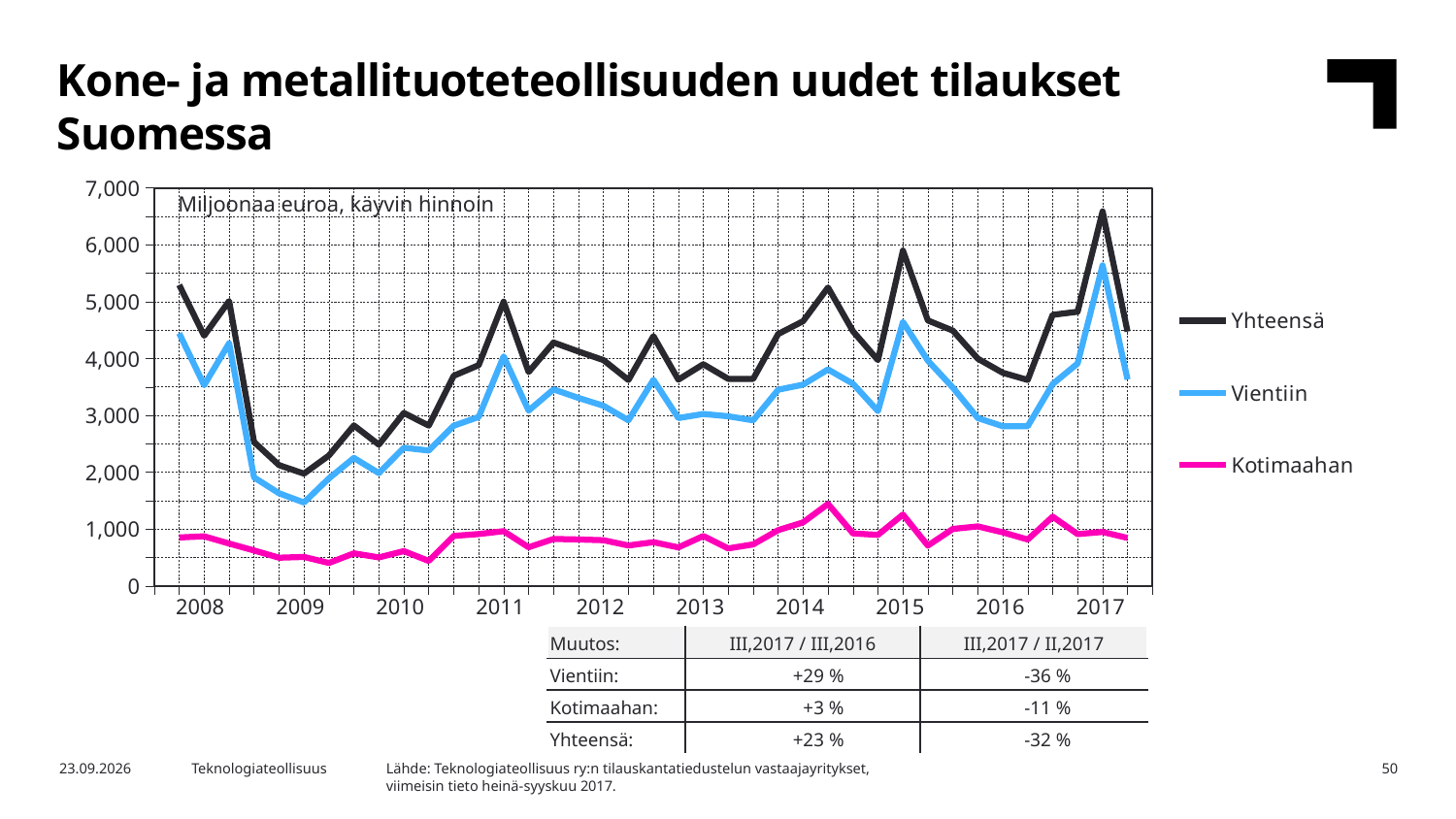
Which series is larger in 2015, Vientiin or Kotimaahan? Vientiin What unit is stated in the text inside the chart area? Miljoonaa euroa, käyvin hinnoin How many series does the legend list? 3 How many year labels are shown on the x axis? 10 Which series has the highest values throughout the chart? Yhteensä What kind of chart is shown on the slide? Line chart Is the peak value of Yhteensä in 2017 greater or less than 6,000? greater Does the Yhteensä series rise or fall from the start of 2008 to 2009? Fall Which series has the lowest values throughout the chart? Kotimaahan Is the value for Kotimaahan at the start of 2008 greater or less than 2,000? less Is the peak value of Vientiin in 2017 greater or less than 5,000? greater